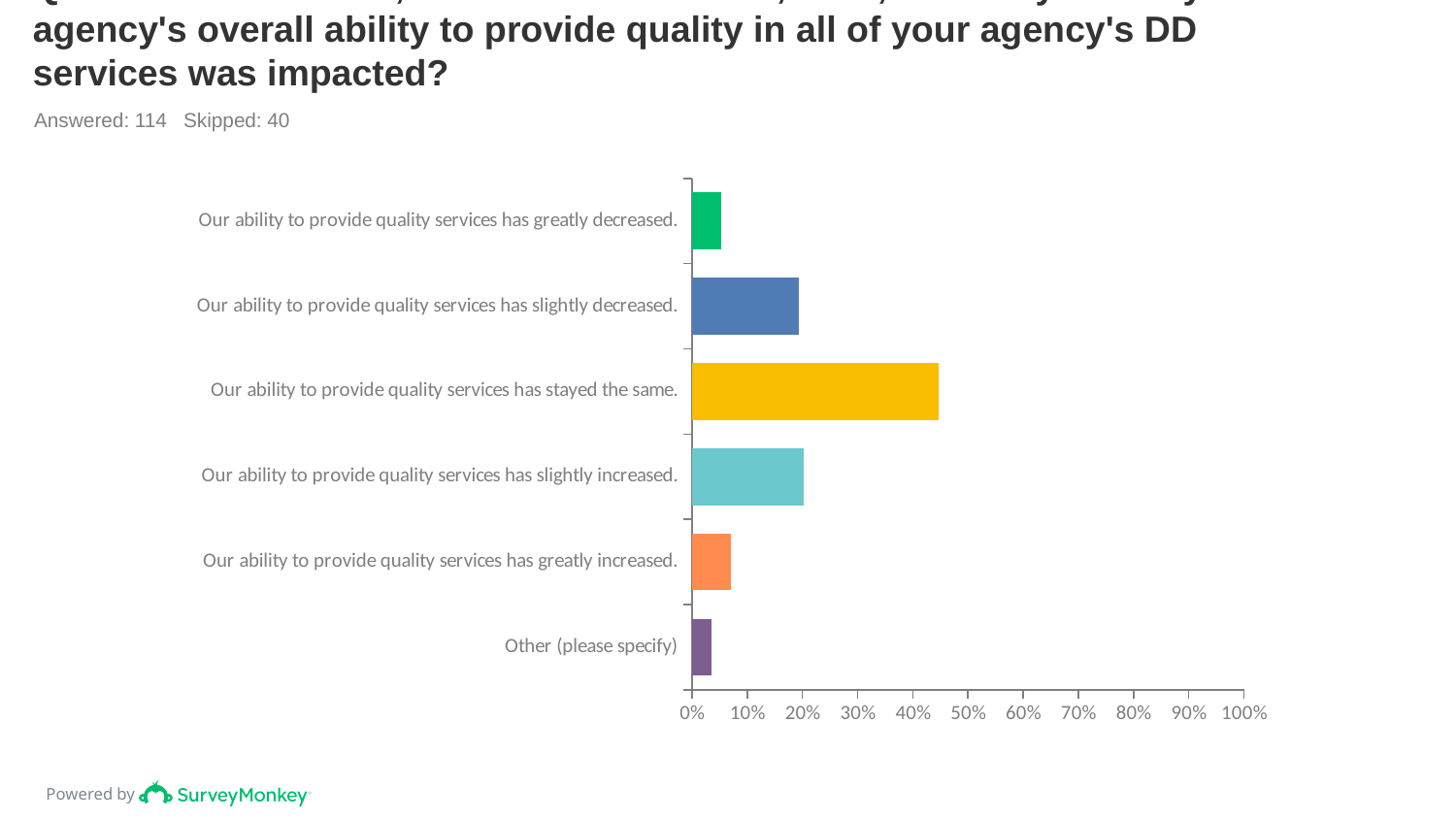
Is the value for "Our ability to provide quality services has greatly decreased." greater or less than 10%? less Is the value for "Our ability to provide quality services has stayed the same." greater or less than 40%? greater How many categories are plotted in the chart? 6 Which is larger: the value for "Our ability to provide quality services has slightly increased." or the value for "Other (please specify)"? Our ability to provide quality services has slightly increased. Which category has the highest value? Our ability to provide quality services has stayed the same. Which is larger: the value for "Our ability to provide quality services has stayed the same." or the value for "Our ability to provide quality services has slightly decreased."? Our ability to provide quality services has stayed the same. Is the value for "Our ability to provide quality services has stayed the same." greater or less than 50%? less What is the maximum value shown on the horizontal axis? 100% What kind of chart is shown on the slide? bar chart